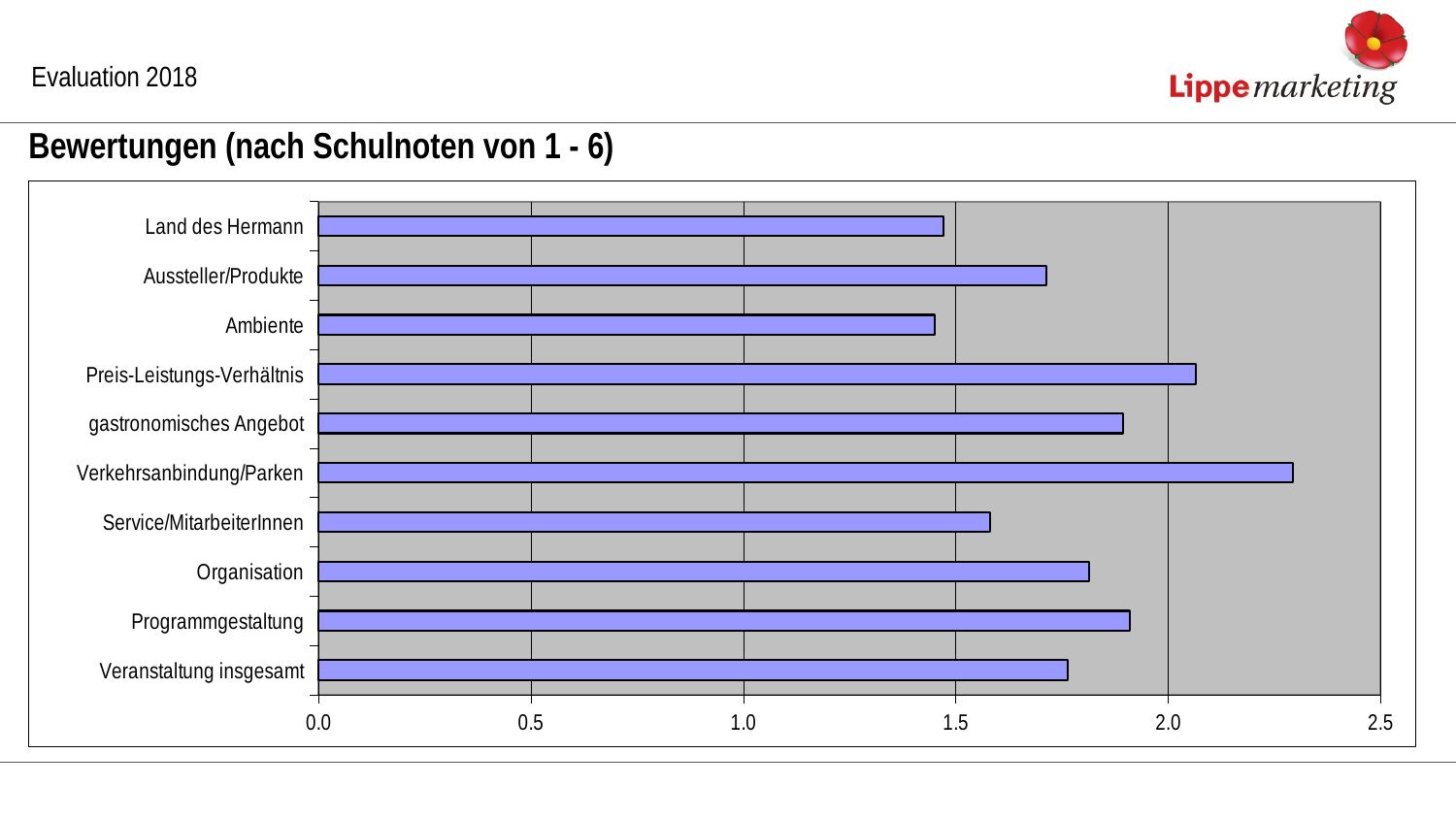
Which category has the highest value in the chart? Verkehrsanbindung/Parken Is the value for Ambiente greater or less than 1.5? less Is the value for Organisation greater or less than 2.0? less What kind of chart is shown on the slide? bar chart Which is larger, the value for Aussteller/Produkte or the value for Ambiente? Aussteller/Produkte What is the highest value shown on the horizontal axis? 2.5 Is the value for gastronomisches Angebot greater or less than 2.0? less Which is larger, the value for Programmgestaltung or the value for Service/MitarbeiterInnen? Programmgestaltung What is the title of the chart? Bewertungen (nach Schulnoten von 1 - 6) How many categories are plotted in the chart? 10